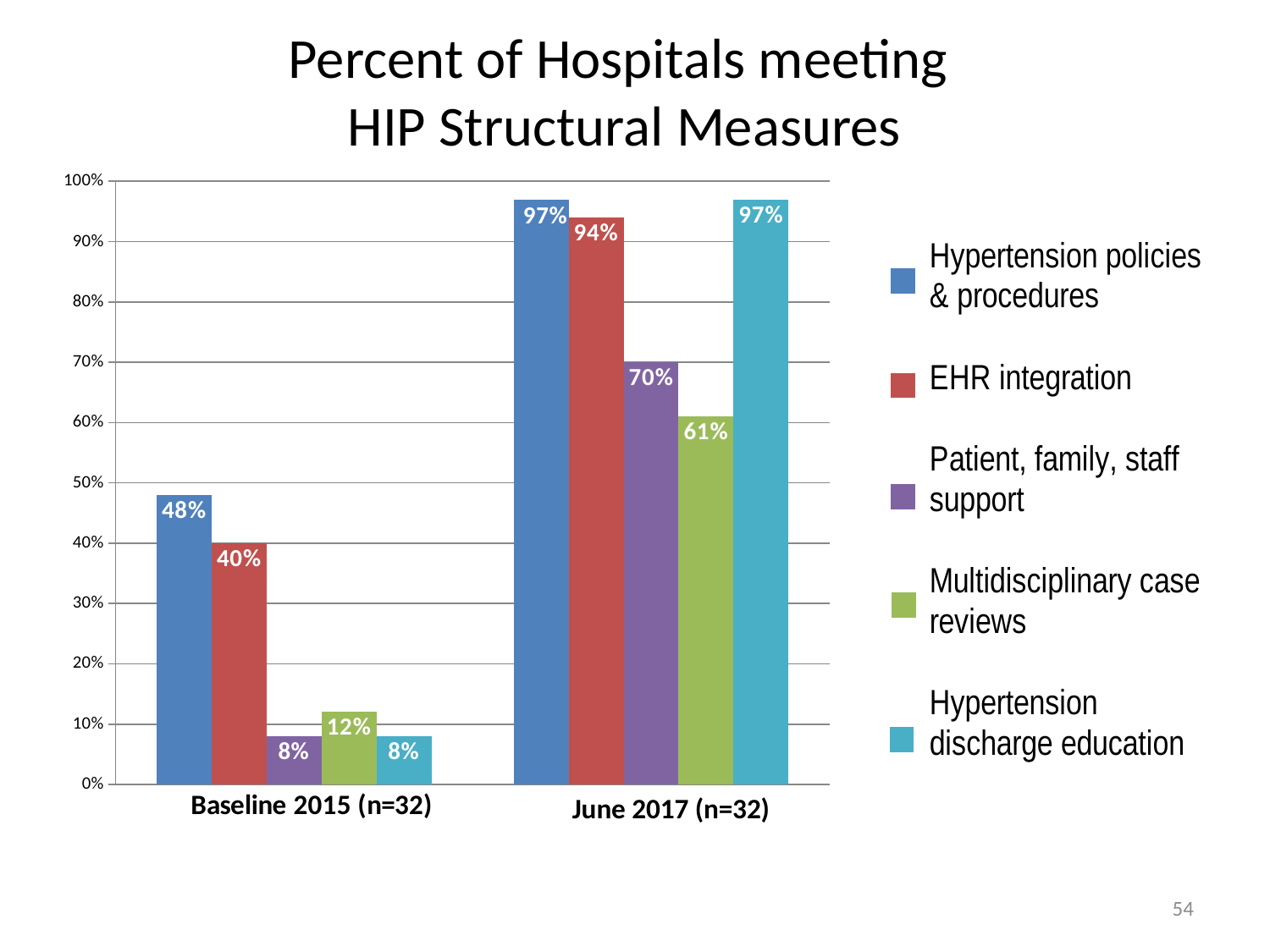
What kind of chart is shown on the slide? Bar chart What is the value for Patient, family, staff support at Baseline 2015 (n=32)? 8% Do the values for EHR integration rise or fall from Baseline 2015 to June 2017? Rise What is the difference between the June 2017 and Baseline 2015 values for Hypertension discharge education? 89 percentage points How many categories are shown on the x axis? 2 Which measure has the lowest value in June 2017 (n=32)? Multidisciplinary case reviews What is the difference between Hypertension policies & procedures and EHR integration in June 2017 (n=32)? 3 percentage points Which measure has the highest value at Baseline 2015 (n=32)? Hypertension policies & procedures How many series does the legend list? 5 What is the value for Multidisciplinary case reviews in June 2017 (n=32)? 61% Which is larger at Baseline 2015 (n=32): Multidisciplinary case reviews or Hypertension discharge education? Multidisciplinary case reviews What percent of hospitals met the EHR integration measure at Baseline 2015 (n=32)? 40%